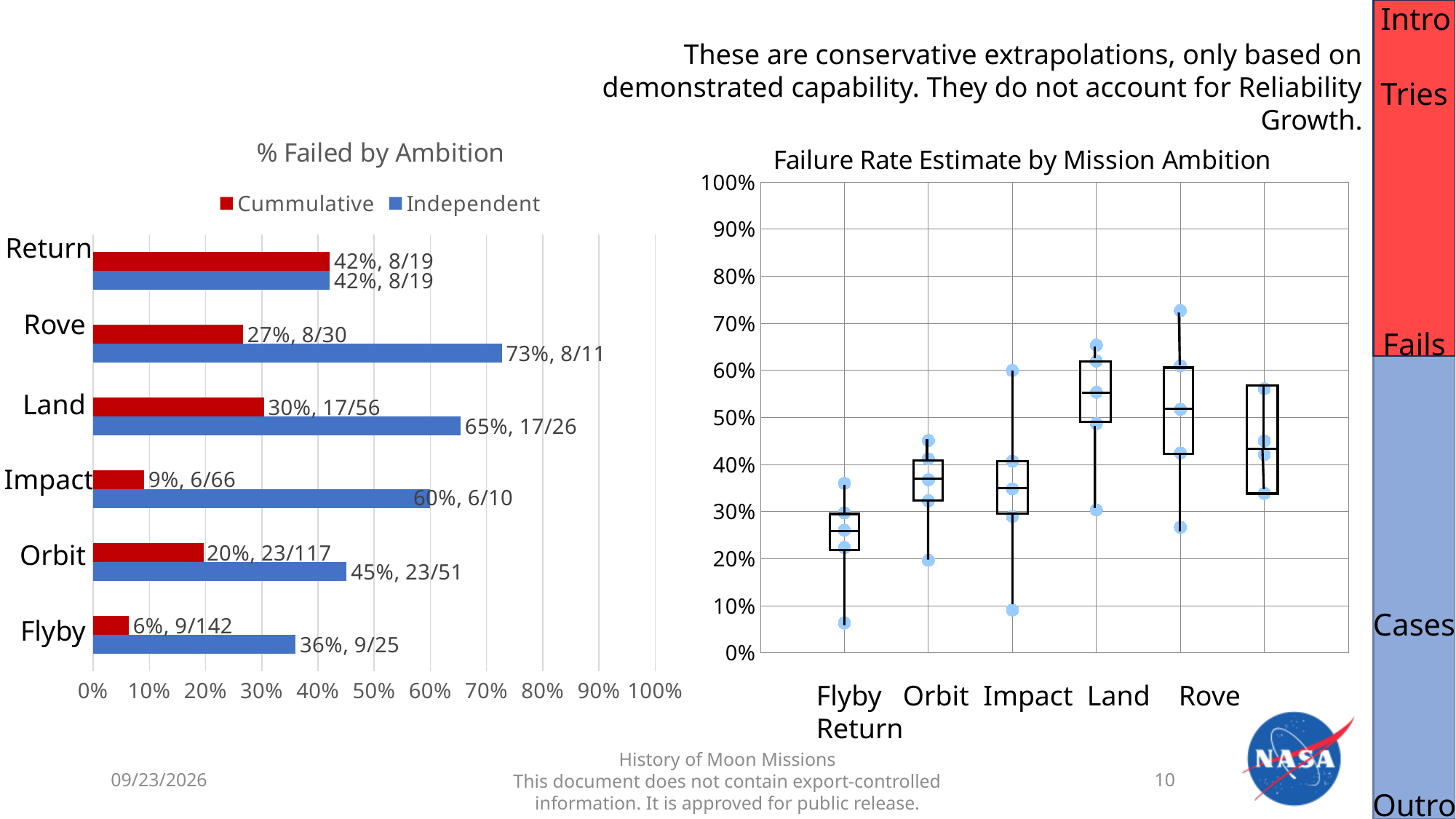
In the '% Failed by Ambition' chart, which is larger: the Independent value for Impact or the Independent value for Orbit? Impact In the '% Failed by Ambition' chart, what is the Cummulative value for Flyby? 6%, 9/142 In the 'Failure Rate Estimate by Mission Ambition' chart, is the median line for Flyby greater or less than 30%? less In the '% Failed by Ambition' chart, what is the Cummulative value for Orbit? 20%, 23/117 In the 'Failure Rate Estimate by Mission Ambition' chart, how many mission ambition categories are shown on the x axis? 6 In the '% Failed by Ambition' chart, which category has the lowest Cummulative percentage? Flyby In the 'Failure Rate Estimate by Mission Ambition' chart, is the median line for Land greater or less than 50%? greater In the '% Failed by Ambition' chart, which category has the highest Independent percentage? Rove What kind of chart is '% Failed by Ambition'? Bar chart In the '% Failed by Ambition' chart, how many series does the legend list? 2 In the '% Failed by Ambition' chart, what is the Independent value for Rove? 73%, 8/11 In the '% Failed by Ambition' chart, what is the difference in percentage points between the Independent and Cummulative values for Land? 35%